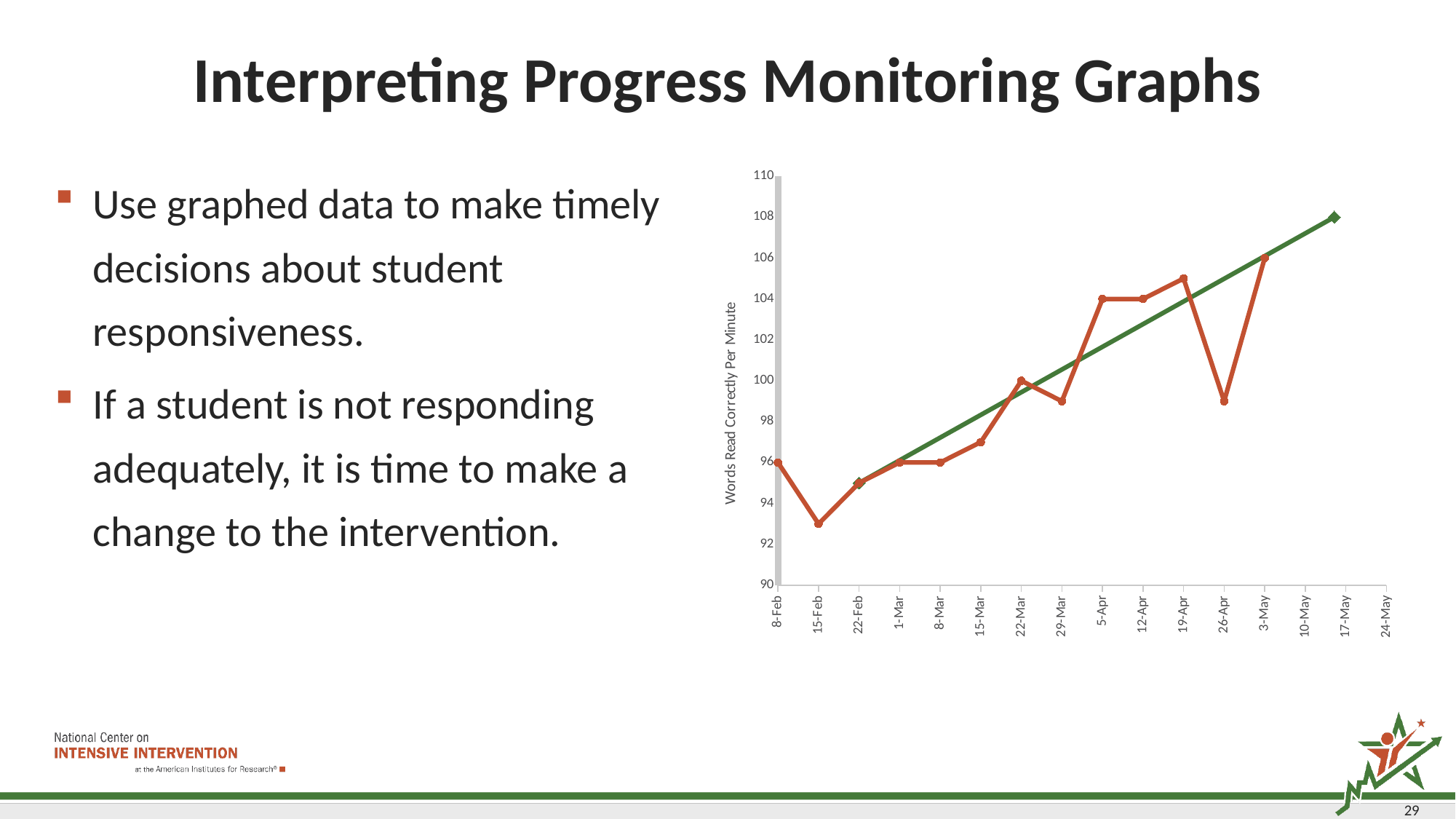
Which date has the larger value on the red line, 5-Apr or 26-Apr? 5-Apr Which date has the larger value on the red line, 22-Mar or 29-Mar? 22-Mar Is the value of the red line on 19-Apr greater or less than 102? greater Is the value of the red line on 15-Feb greater or less than 94? less On which date does the red line reach its lowest value? 15-Feb Is the value of the red line on 26-Apr greater or less than 100? less What is the title of the vertical axis? Words Read Correctly Per Minute What type of chart is shown on the slide? Line chart On which date does the red line reach its highest value? 3-May Overall, does the red line rise or fall from 8-Feb to 3-May? Rise How many data points are plotted on the red line? 13